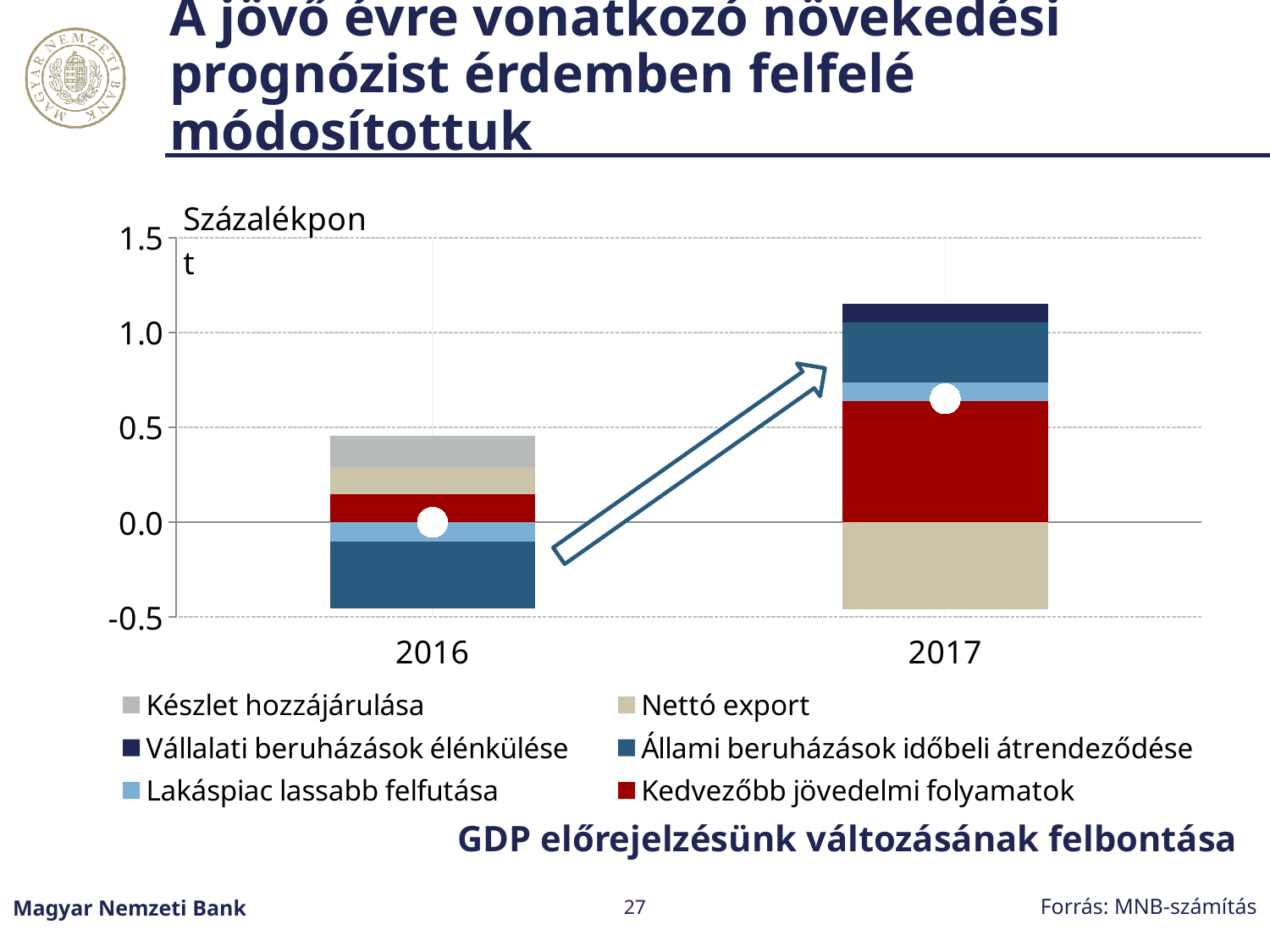
In which year is the white marker positioned higher on the chart? 2017 Which year has the taller positive stacked bar, 2016 or 2017? 2017 What is the title of the chart? GDP előrejelzésünk változásának felbontása How many series does the chart legend list? 6 What unit is shown on the vertical axis of the chart? Százalékpont Is the Nettó export contribution in 2017 greater or less than 0.0? less Is the Kedvezőbb jövedelmi folyamatok contribution in 2017 greater or less than 0.5? greater What kind of chart is shown on the slide? Stacked bar chart Is the top of the stacked bar for 2016 greater or less than 1.0? less How many years (categories) are shown on the x axis of the chart? 2